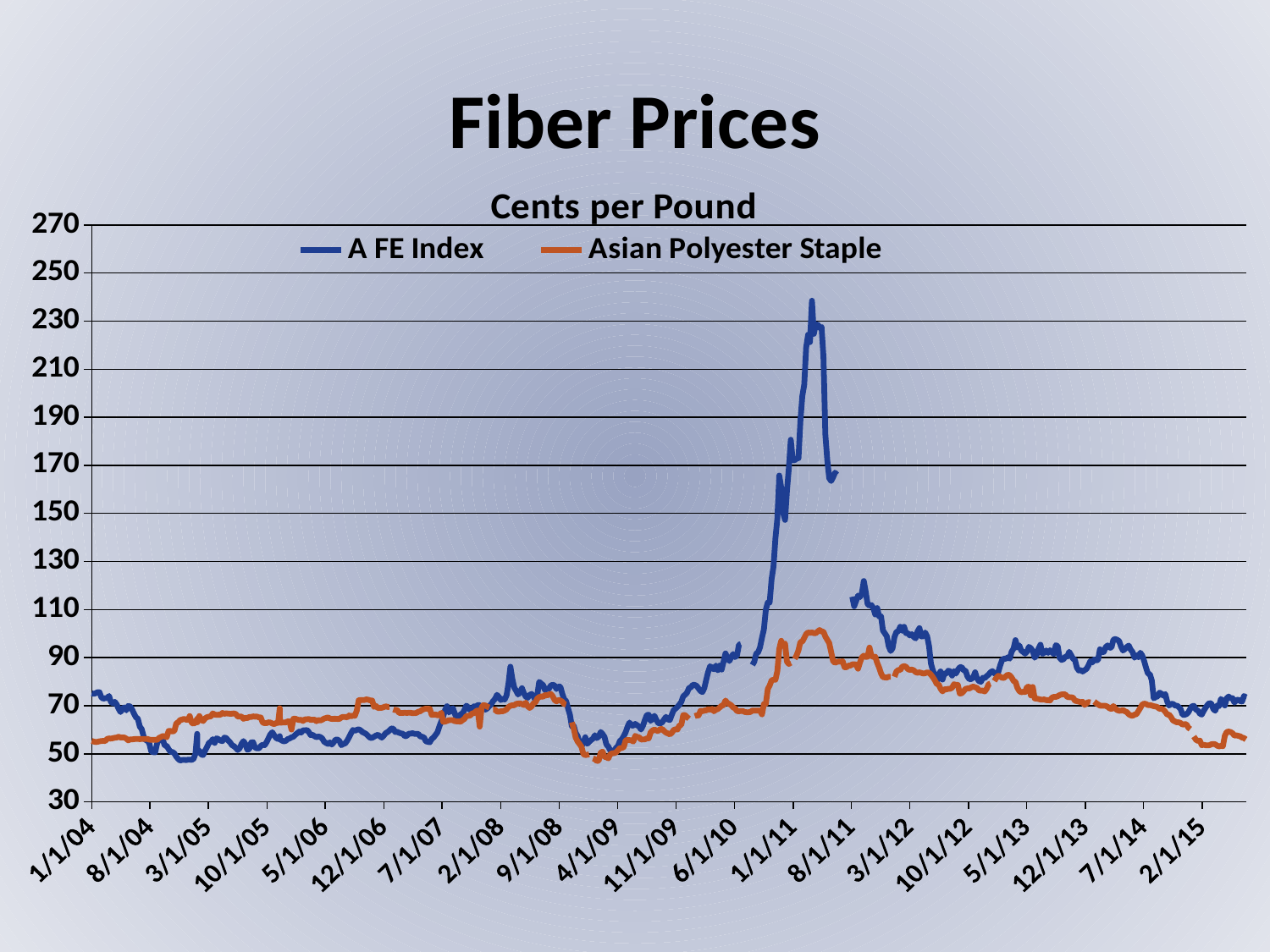
Is the peak value of the A FE Index greater or less than 210? greater Does the Asian Polyester Staple line generally rise or fall between 8/1/11 and 2/1/15? fall Around 5/1/13, which series has the higher value, A FE Index or Asian Polyester Staple? A FE Index What is the highest value shown on the vertical axis? 270 How many series does the legend list? 2 What kind of chart is shown on the slide? line chart Which series reaches the highest value on the chart? A FE Index What unit is given in the chart's subtitle? Cents per Pound What is the title of the chart? Cents per Pound Is the value of the A FE Index at 1/1/04 greater or less than 50? greater Is the highest value of Asian Polyester Staple greater or less than 130? less Around 3/1/05, which series has the higher value, A FE Index or Asian Polyester Staple? Asian Polyester Staple